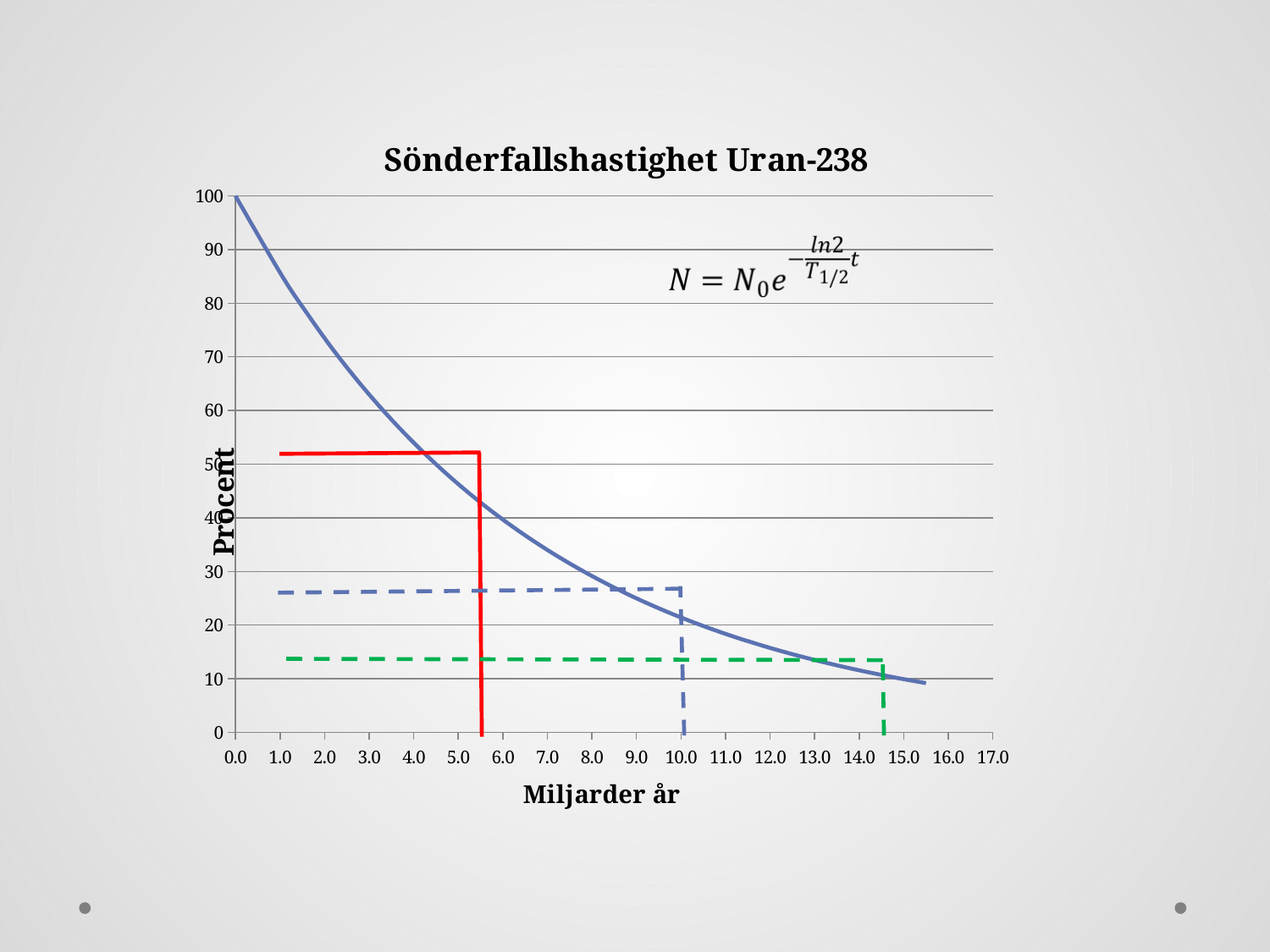
Is the value of the curve at 1.0 greater or less than 80? greater Is the value of the curve at 12.0 greater or less than 20? less Is the value of the curve at 4.0 greater or less than 50? greater At which x-axis value is the curve highest? 0.0 What is the label of the x axis? Miljarder år Do the values of the curve rise or fall as the x axis increases? fall What is the value of the curve at 0.0 on the x axis? 100 Which is larger, the value of the curve at 3.0 or at 9.0? 3.0 What kind of chart is shown on the slide? line chart What is the title of the chart? Sönderfallshastighet Uran-238